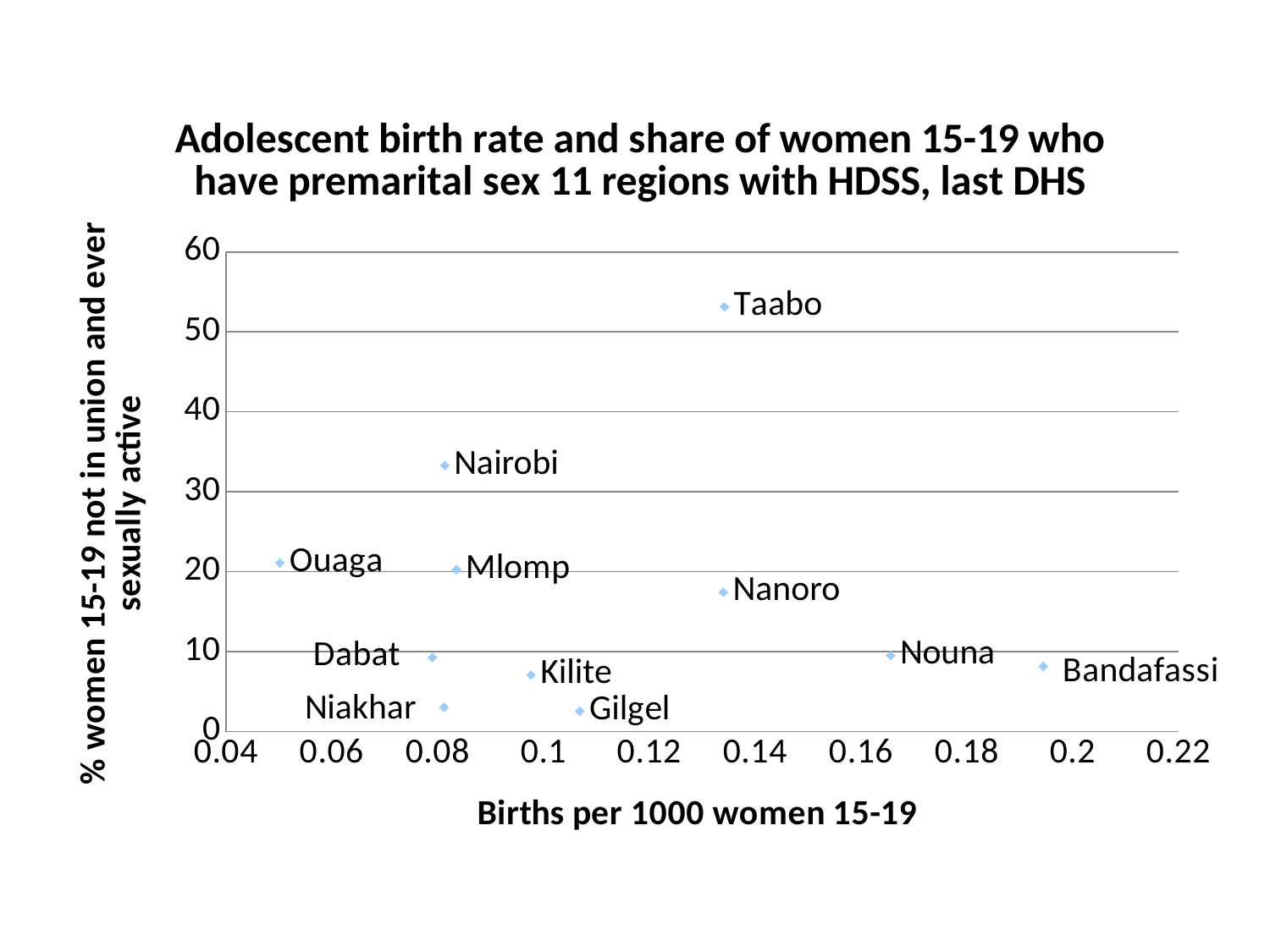
What kind of chart is shown on the slide? scatter chart Is the share of women 15-19 not in union and ever sexually active for Nanoro greater or less than 20? less Is the share of women 15-19 not in union and ever sexually active for Nairobi greater or less than 30? greater Which region has the lowest value on the x axis (births per 1000 women 15-19)? Ouaga Which region has a higher birth rate per 1000 women 15-19, Bandafassi or Nouna? Bandafassi Which region has the highest share of women 15-19 not in union and ever sexually active? Taabo Which has a higher share of women 15-19 not in union and ever sexually active, Nairobi or Mlomp? Nairobi Which region has the highest value on the x axis (births per 1000 women 15-19)? Bandafassi Is the share of women 15-19 not in union and ever sexually active for Taabo greater or less than 50? greater What is the title of the x axis? Births per 1000 women 15-19 How many regions are plotted as points on the chart? 11